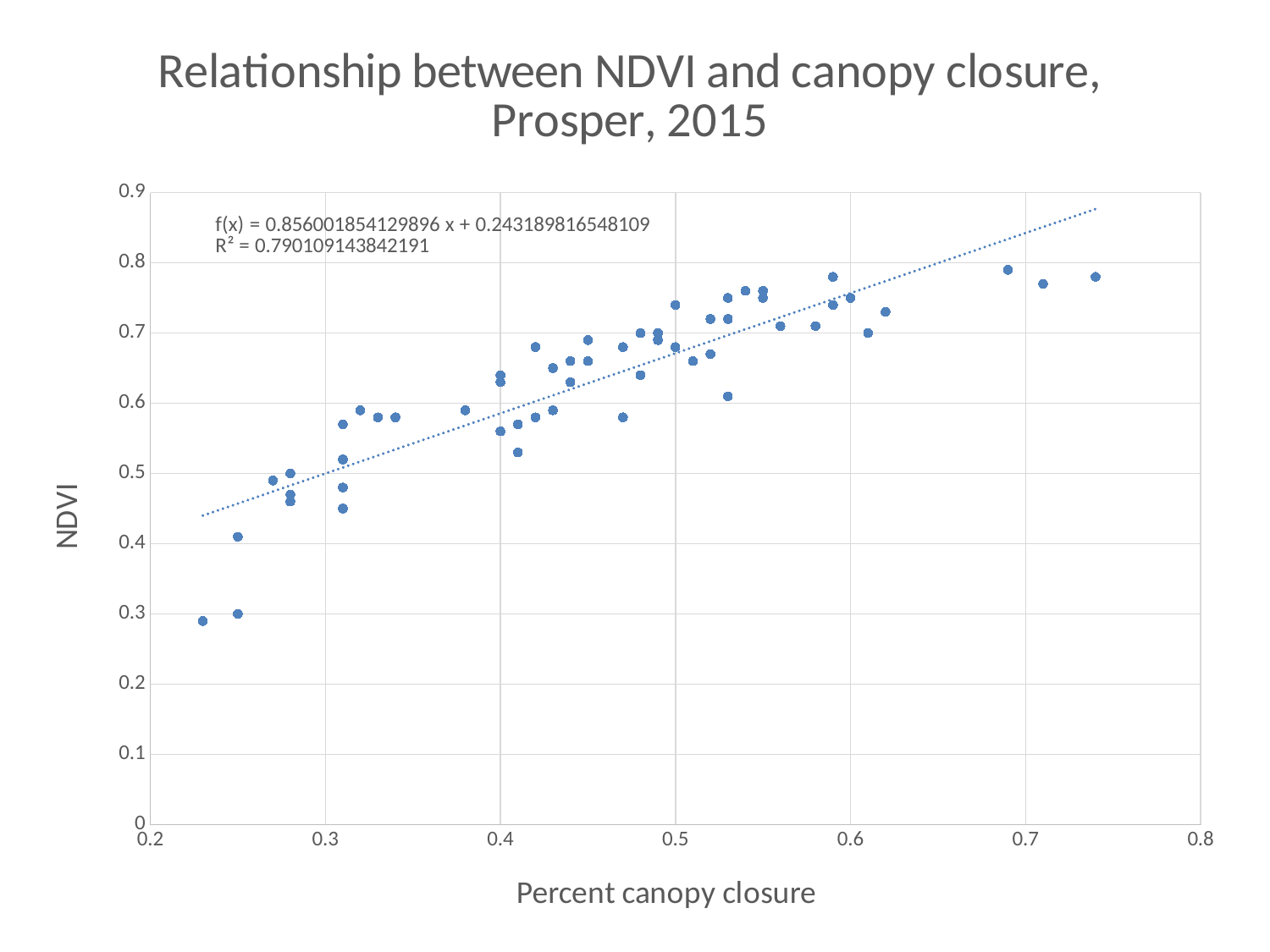
Is the NDVI value of the leftmost point greater or less than 0.4? less What is the label of the x axis? Percent canopy closure Is the lowest NDVI value plotted greater or less than 0.2? greater What is the intercept in the trendline equation printed on the chart? 0.243189816548109 What kind of chart is shown on the slide? Scatter plot Is the NDVI value of the rightmost point greater or less than 0.7? greater What R² value is printed on the chart for the fitted trendline? 0.790109143842191 Which has the higher NDVI value, the leftmost point or the rightmost point? The rightmost point What is the title of the chart? Relationship between NDVI and canopy closure, Prosper, 2015 What is the slope (coefficient of x) in the trendline equation printed on the chart? 0.856001854129896 As percent canopy closure increases along the x axis, does NDVI generally rise or fall? Rise